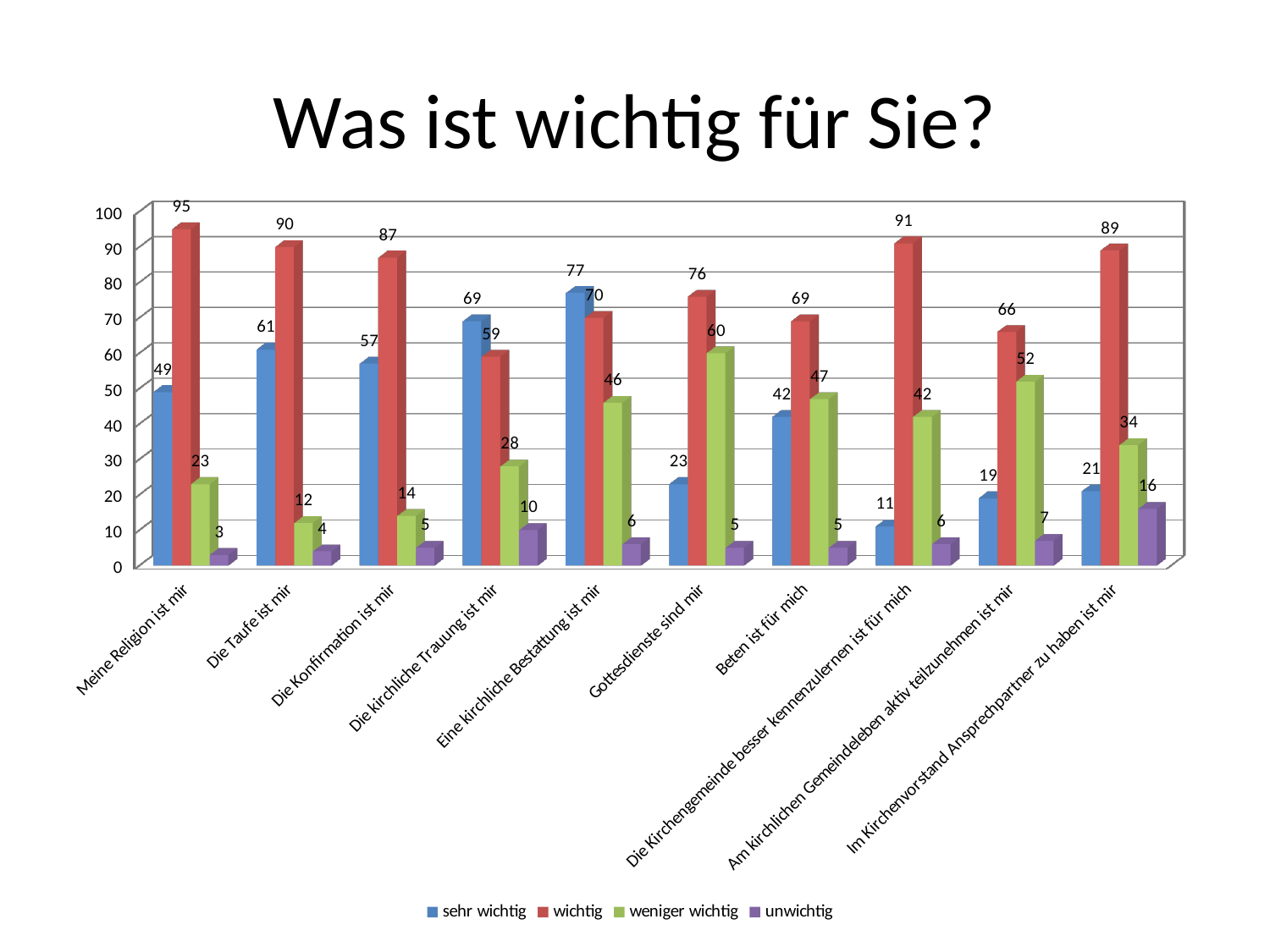
What kind of chart is shown on the slide? bar chart What is the value of "weniger wichtig" for "Gottesdienste sind mir"? 60 For "Die kirchliche Trauung ist mir", which is larger: "sehr wichtig" or "wichtig"? sehr wichtig How many series does the legend list? 4 What is the value of "wichtig" for "Die Taufe ist mir"? 90 What is the value of "unwichtig" for "Im Kirchenvorstand Ansprechpartner zu haben ist mir"? 16 What is the title of the chart? Was ist wichtig für Sie? Which category has the lowest "sehr wichtig" value? Die Kirchengemeinde besser kennenzulernen ist für mich How many categories are shown on the x axis? 10 Which category has the highest "wichtig" value? Meine Religion ist mir What is the value of "sehr wichtig" for "Meine Religion ist mir"? 49 What is the difference between the "sehr wichtig" and "wichtig" values for "Eine kirchliche Bestattung ist mir"? 7